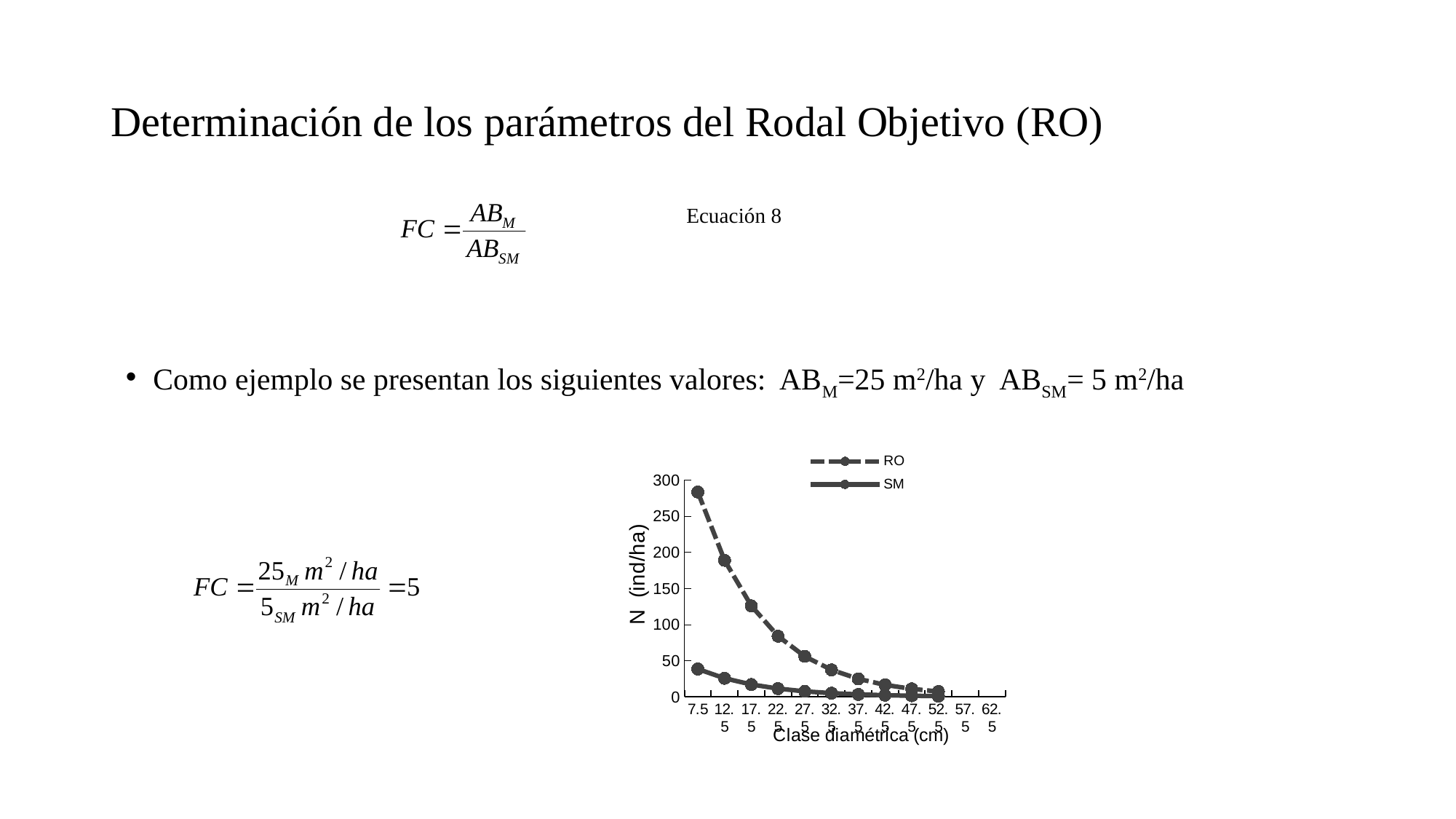
What kind of chart is shown on the slide? line chart Which two series are listed in the chart legend? RO and SM Do the values of the RO series rise or fall as the diameter class increases? fall Is the value of the RO series at diameter class 7.5 greater or less than 250? greater Is the value of the RO series at diameter class 17.5 greater or less than 100? greater What is the title of the chart's y axis? N (ind/ha) At diameter class 12.5, which series has the larger value, RO or SM? RO How many diameter class labels are shown on the x axis of the chart? 12 Is the value of the SM series at diameter class 7.5 greater or less than 50? less At which diameter class does the RO series reach its highest value? 7.5 Do the values of the SM series rise or fall as the diameter class increases? fall How many series does the chart legend list? 2